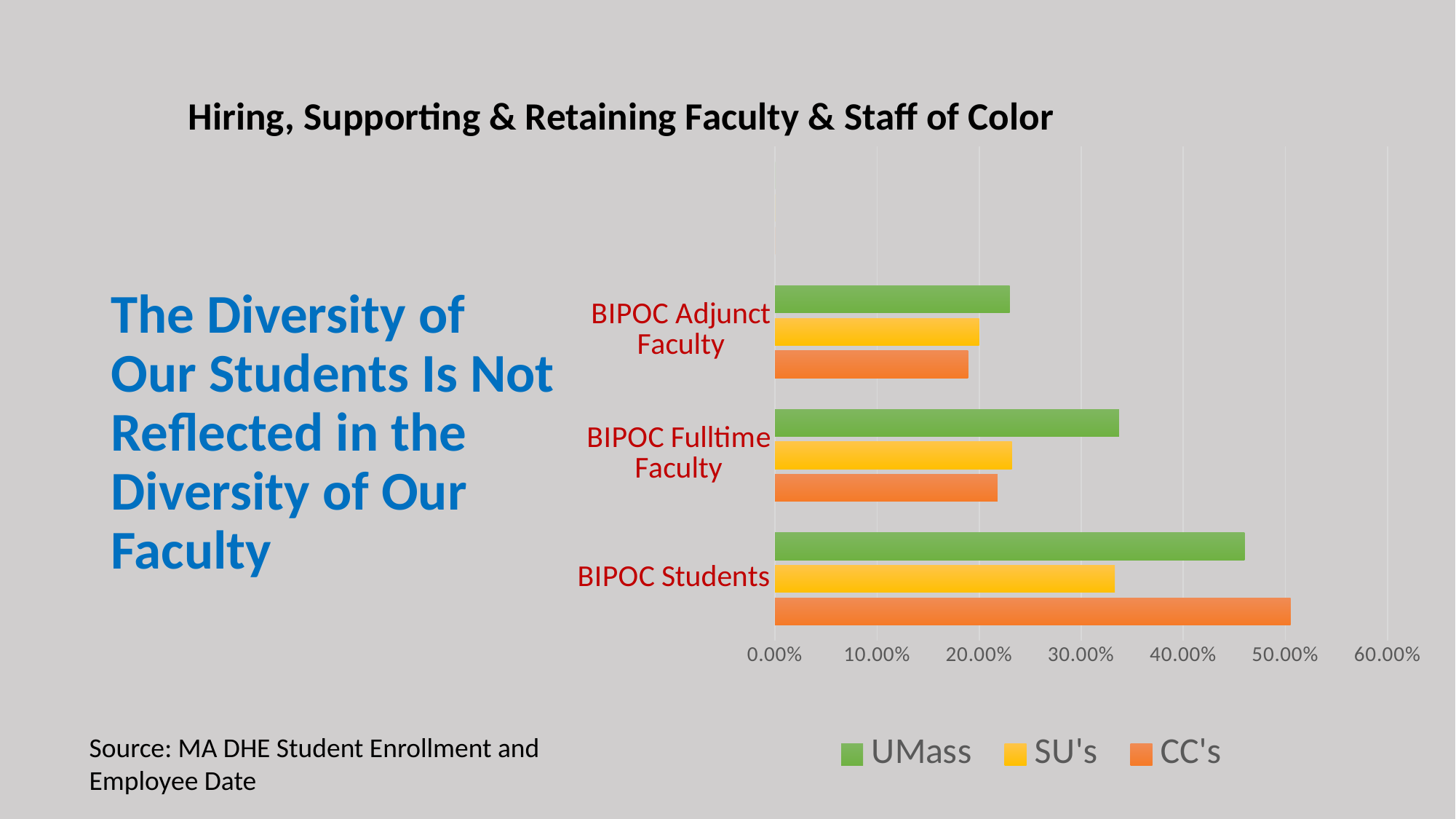
How many series does the chart legend list? 3 For the UMass series, which category has the lowest value? BIPOC Adjunct Faculty Which series has the lowest value for BIPOC Students? SU's Is the UMass value for BIPOC Adjunct Faculty greater or less than 20.00%? greater For the UMass series, which category has the highest value? BIPOC Students Which series has the highest value for BIPOC Students? CC's Is the UMass value for BIPOC Students greater or less than 40.00%? greater What is the title shown above the chart? Hiring, Supporting & Retaining Faculty & Staff of Color For BIPOC Fulltime Faculty, which is larger: the UMass value or the SU's value? UMass What kind of chart is shown on the slide? bar chart Is the CC's value for BIPOC Fulltime Faculty greater or less than 30.00%? less How many categories are shown on the chart's vertical axis? 3